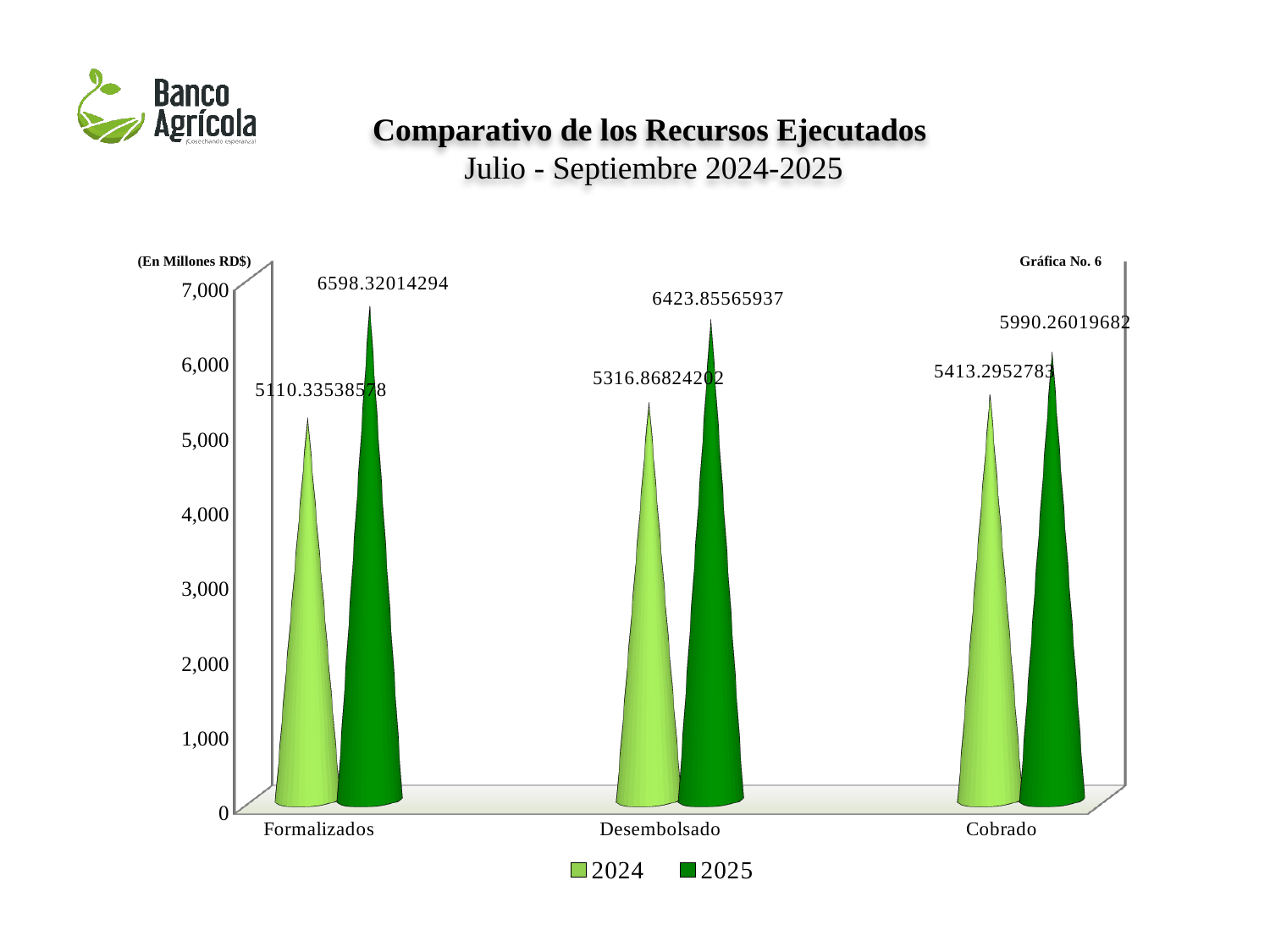
How many series does the legend list? 2 For Cobrado, which series is larger, 2024 or 2025? 2025 What is the 2024 value for Formalizados? 5110.33538578 Is the 2024 value for Desembolsado greater or less than 6,000? less Which category has the highest 2025 value? Formalizados Do the 2025 values rise or fall from Formalizados to Cobrado? fall What is the 2025 value for Cobrado? 5990.26019682 Which category has the lowest 2024 value? Formalizados What is the 2025 value for Formalizados? 6598.32014294 How many categories are shown on the x axis? 3 What kind of chart is shown on the slide? bar chart What is the 2025 value for Desembolsado? 6423.85565937